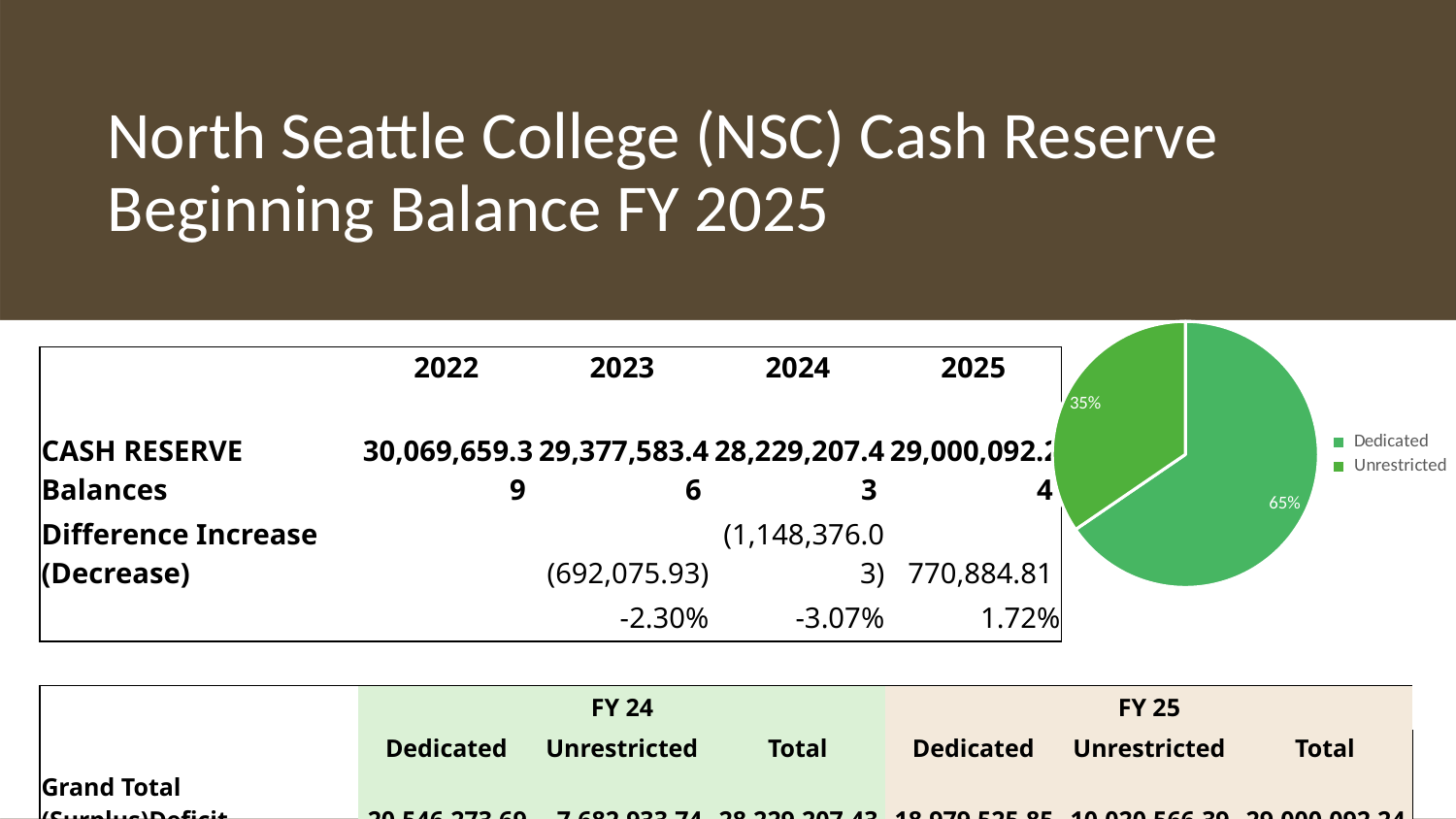
Is the Unrestricted share in the pie chart greater or less than 50%? less In the pie chart, what share is labelled for the Unrestricted slice? 35% How many slices does the pie chart have? 2 What kind of chart is shown on the right side of the slide? pie chart Is the Dedicated share in the pie chart greater or less than 50%? greater How many entries does the legend of the pie chart list? 2 Which slice of the pie chart is the largest? Dedicated What are the two legend entries of the pie chart? Dedicated and Unrestricted Which slice of the pie chart is the smallest? Unrestricted In the pie chart, which is larger, the Dedicated slice or the Unrestricted slice? Dedicated What is the difference in percentage points between the Dedicated and Unrestricted slices of the pie chart? 30 percentage points In the pie chart, what share is labelled for the Dedicated slice? 65%